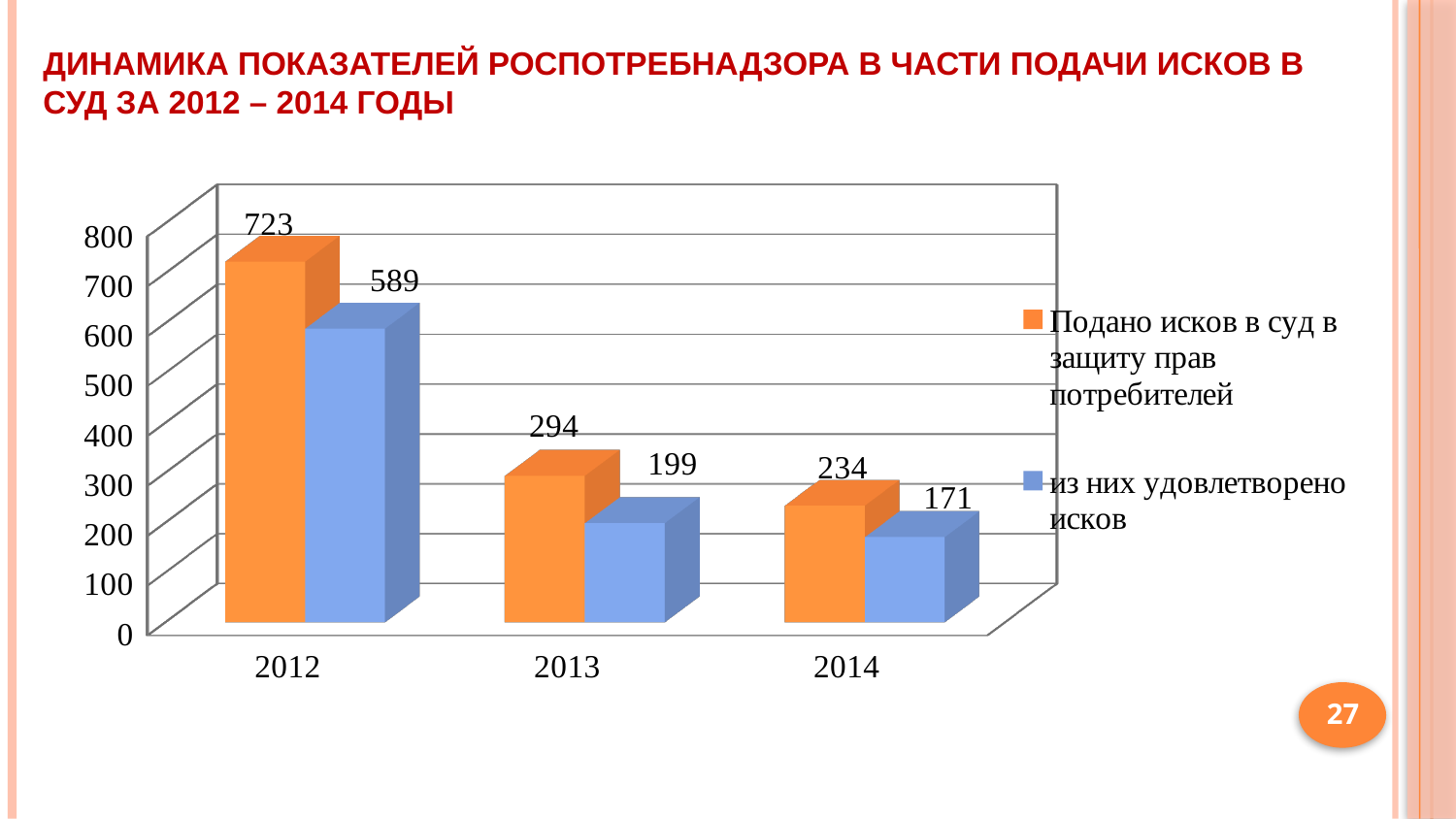
In which year was the number of lawsuits filed (Подано исков) the highest? 2012 In which year was the number of satisfied lawsuits (из них удовлетворено исков) the lowest? 2014 How many lawsuits were satisfied (из них удовлетворено исков) in 2013? 199 Do the values for lawsuits filed (Подано исков) rise or fall from 2012 to 2014? Fall What is the value for 'Подано исков в суд в защиту прав потребителей' in 2014? 234 How many lawsuits were filed in court (Подано исков в суд в защиту прав потребителей) in 2012? 723 By how much did the number of lawsuits filed decrease from 2012 to 2013? 429 Which is larger: the number of satisfied lawsuits in 2012 or the number of lawsuits filed in 2013? Satisfied lawsuits in 2012 (589) How many series does the legend list? 2 What is the difference between lawsuits filed and lawsuits satisfied in 2012? 134 What kind of chart is shown on the slide? Bar chart How many years (categories) are shown on the x axis? 3